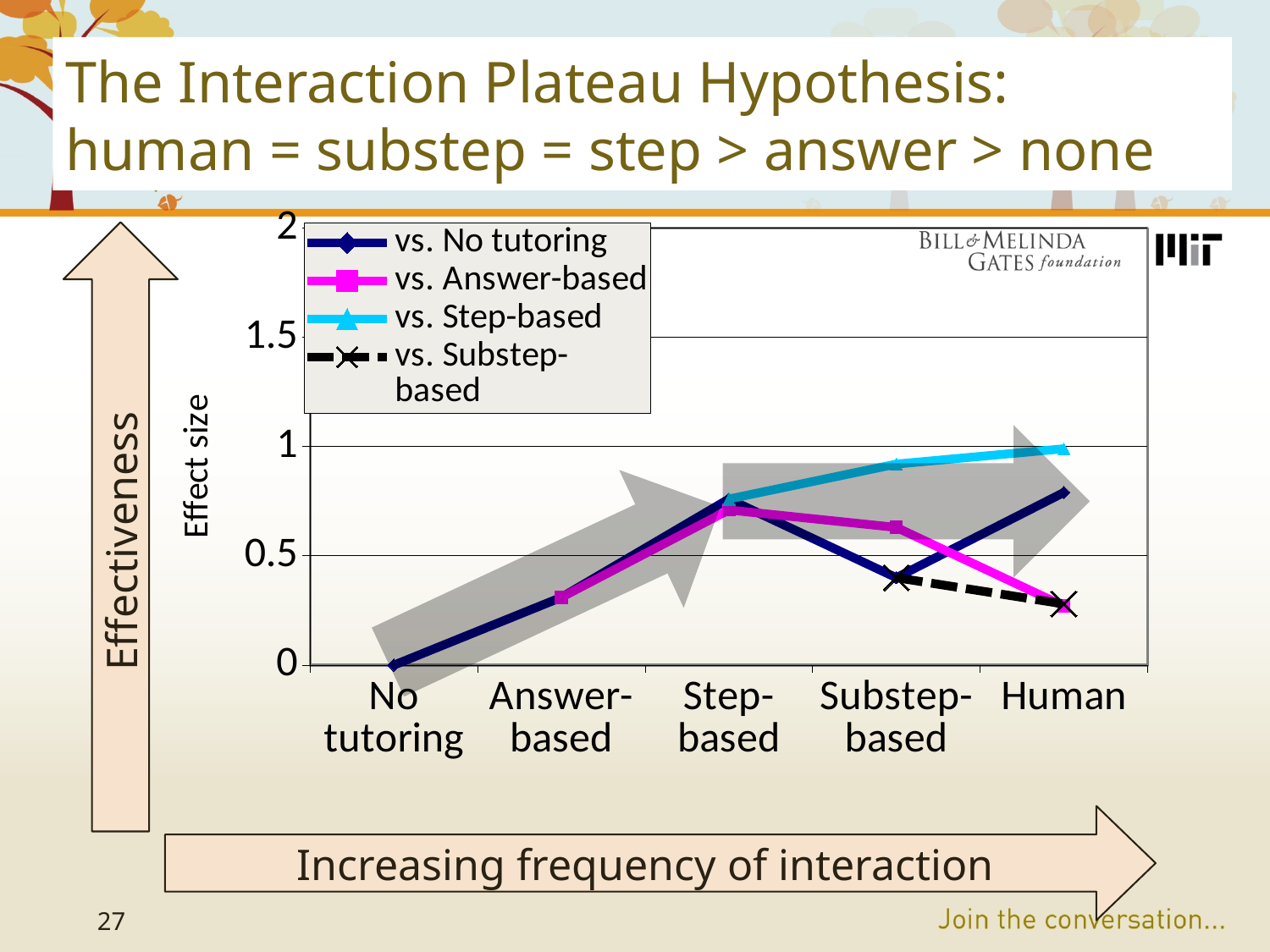
How many series does the chart's legend list? 4 Is the value of the 'vs. Step-based' series at 'Human' greater or less than 0.5? greater How many categories are shown along the x axis of the chart? 5 For the 'vs. Step-based' series, at which category is the value lowest? Step-based Does the 'vs. Substep-based' series rise or fall from 'Substep-based' to 'Human'? fall Is the value of the 'vs. No tutoring' series at 'Answer-based' greater or less than 0.5? less What is the title of the chart's vertical axis? Effect size What is the value of the 'vs. No tutoring' series at the 'No tutoring' category? 0 At the 'Human' category, which series has the larger value: 'vs. Step-based' or 'vs. Answer-based'? vs. Step-based Is the value of the 'vs. Answer-based' series at 'Human' greater or less than 0.5? less At the 'Substep-based' category, which series has the larger value: 'vs. Answer-based' or 'vs. No tutoring'? vs. Answer-based What kind of chart is shown on the slide? line chart